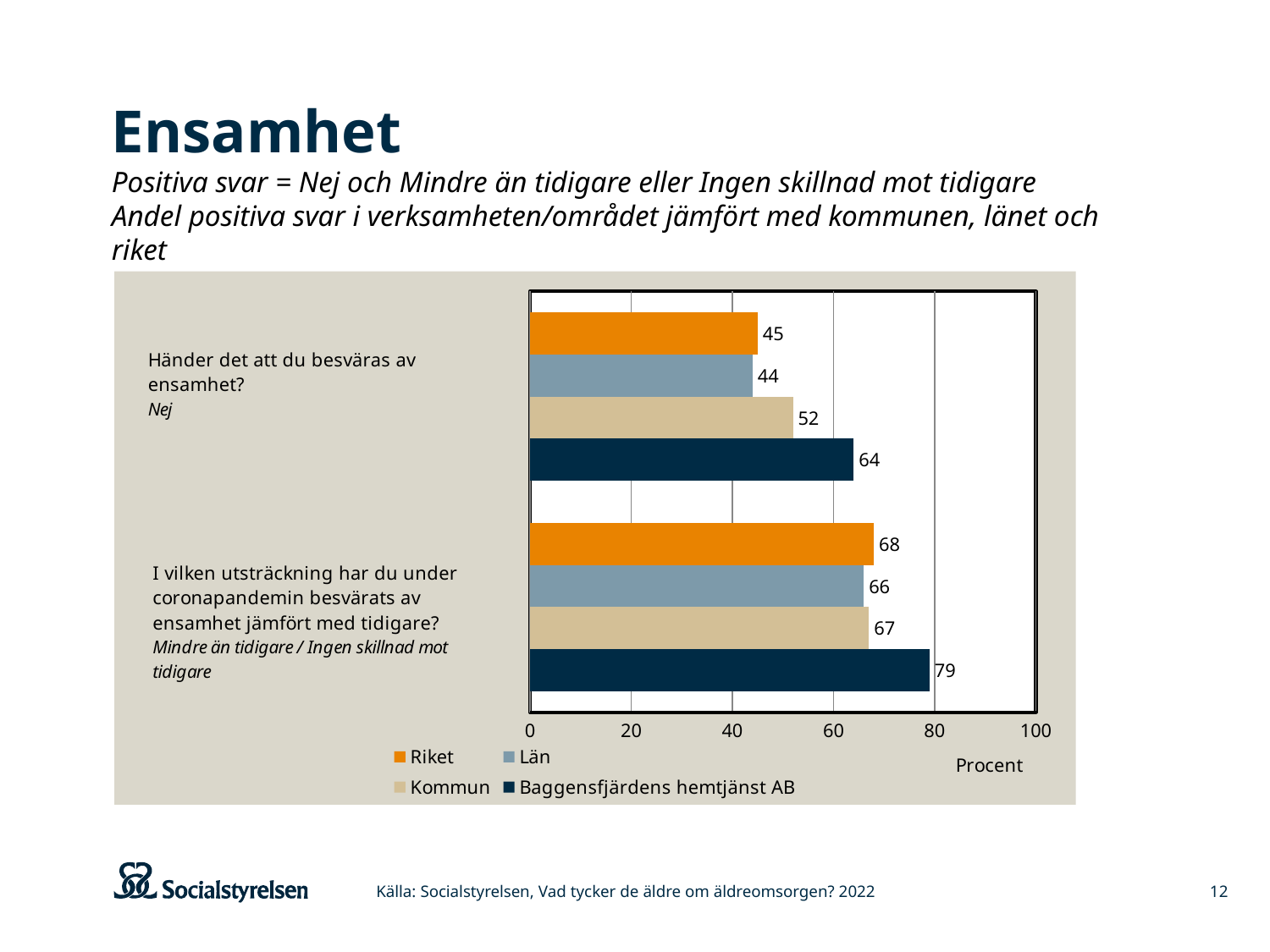
What is the label of the horizontal axis? Procent What kind of chart is shown on the slide? Bar chart Which series has the highest value on the question "I vilken utsträckning har du under coronapandemin besvärats av ensamhet jämfört med tidigare?"? Baggensfjärdens hemtjänst AB Which series has the lowest value on the question "Händer det att du besväras av ensamhet?"? Län What is the value for Kommun on the question "I vilken utsträckning har du under coronapandemin besvärats av ensamhet jämfört med tidigare?"? 67 How many series does the legend list? 4 What is the difference between Baggensfjärdens hemtjänst AB and Riket on the question "Händer det att du besväras av ensamhet?"? 19 Which is larger on the question "Händer det att du besväras av ensamhet?": Kommun or Riket? Kommun What is the difference between Baggensfjärdens hemtjänst AB and Kommun on the question "I vilken utsträckning har du under coronapandemin besvärats av ensamhet jämfört med tidigare?"? 12 What is the value for Riket on the question "I vilken utsträckning har du under coronapandemin besvärats av ensamhet jämfört med tidigare?"? 68 What is the value for Baggensfjärdens hemtjänst AB on the question "Händer det att du besväras av ensamhet?"? 64 What is the value for Län on the question "Händer det att du besväras av ensamhet?"? 44